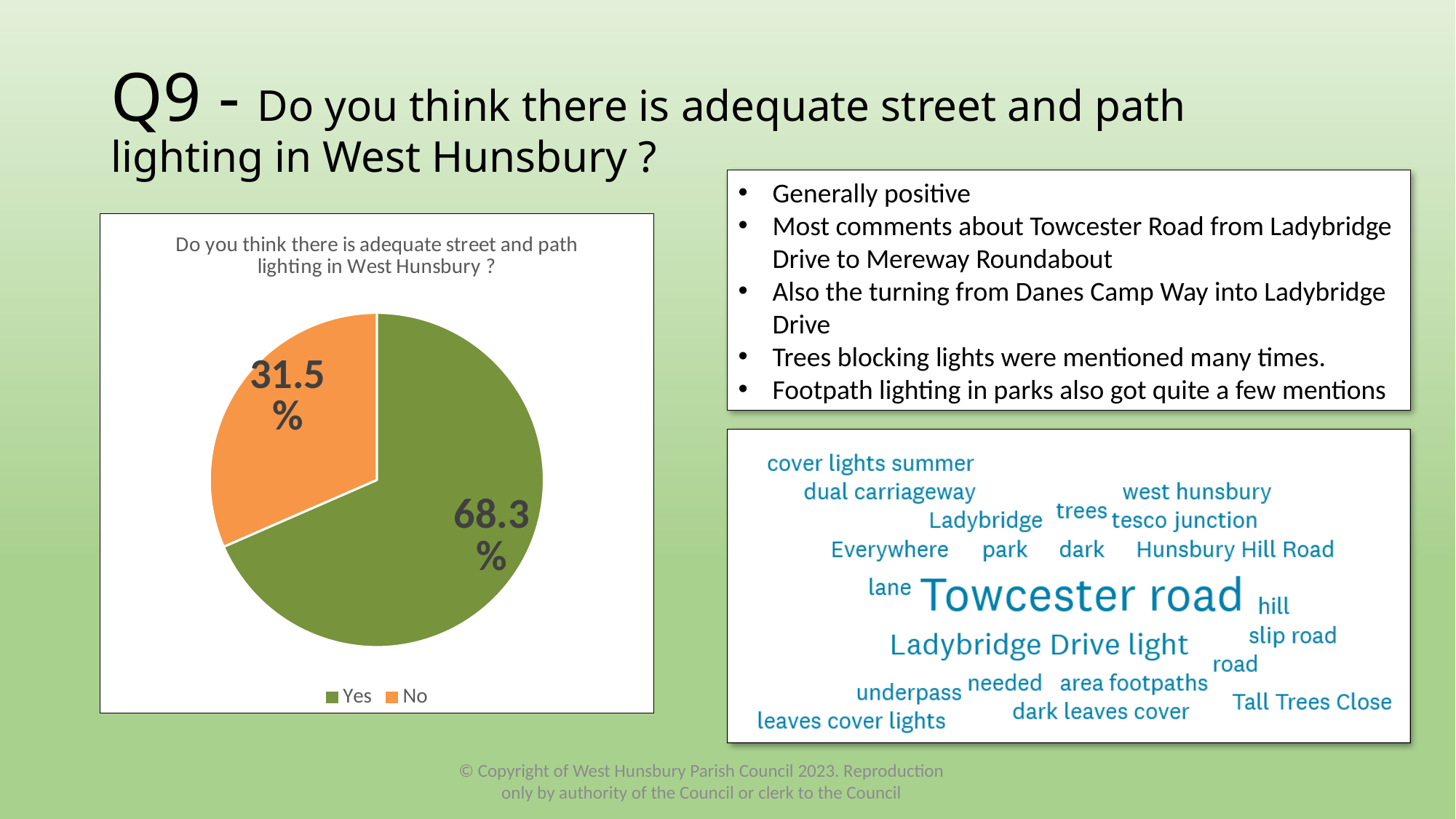
What colour is the Yes slice of the pie chart? green What percentage of respondents answered Yes? 68.3% Which response has the smallest share of the pie? No What percentage of respondents answered No? 31.5% How many entries does the legend list? 2 How many slices does the pie chart have? 2 What is the title of the pie chart? Do you think there is adequate street and path lighting in West Hunsbury ? What is the difference in percentage points between the Yes and No shares? 36.8 What kind of chart is shown on the slide? pie chart Which response has the largest share of the pie? Yes Which is larger, the share for Yes or the share for No? Yes